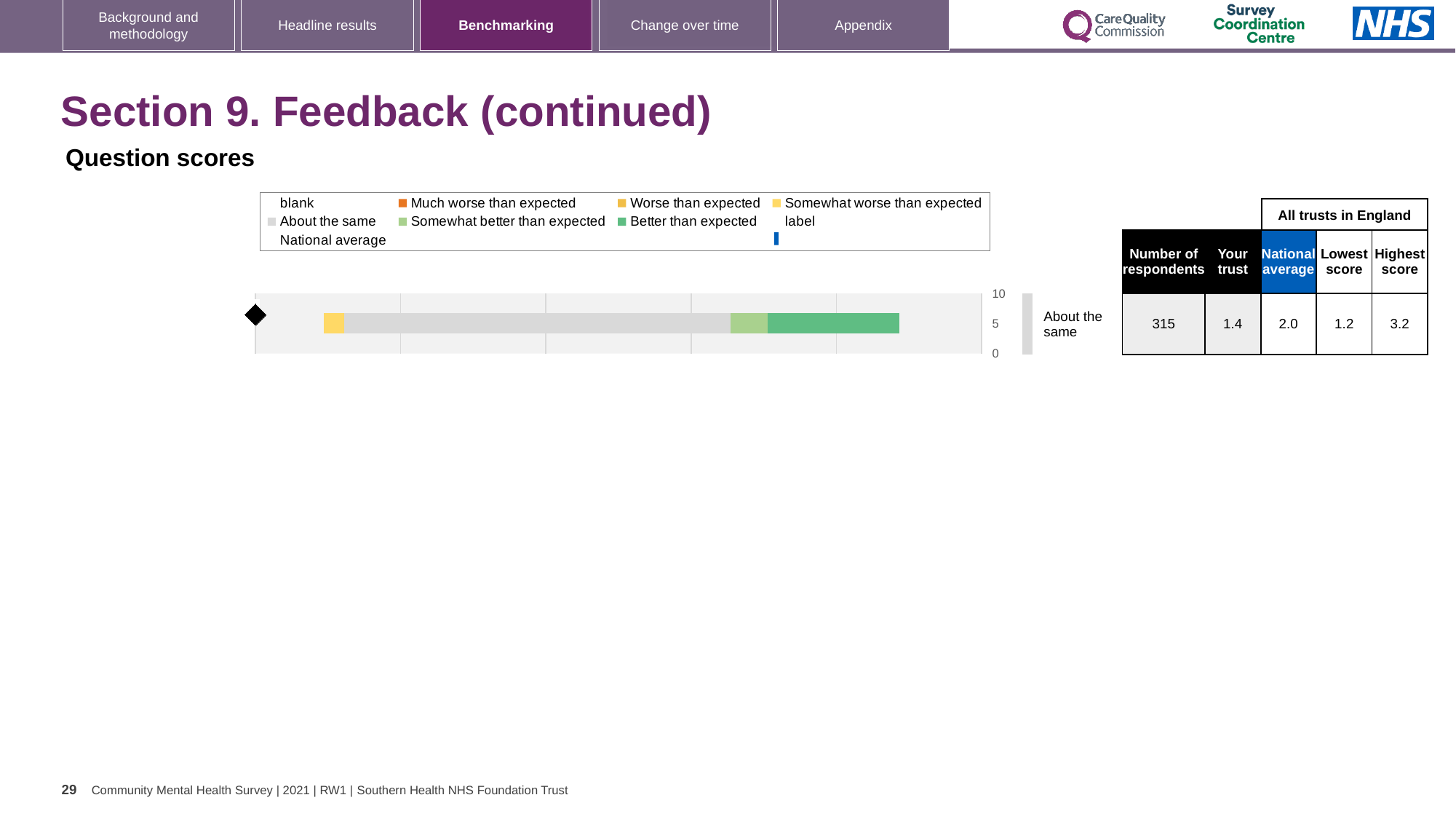
How many question rows (categories) are plotted in the chart? 1 How many entries does the chart legend list? 9 What is the lowest score among all trusts in England for the 'About the same' row? 1.2 What is the label of the single row plotted in the chart? About the same What is the difference between the highest score and the lowest score for the 'About the same' row? 2.0 What kind of chart is shown on the slide? bar chart Which legend entry is shown in dark green? Better than expected Which is larger for the 'About the same' row: the 'Your trust' score or the national average? National average What is the number of respondents for the 'About the same' row? 315 What is the 'Your trust' score for the 'About the same' row? 1.4 What is the national average score for the 'About the same' row? 2.0 What is the highest score among all trusts in England for the 'About the same' row? 3.2